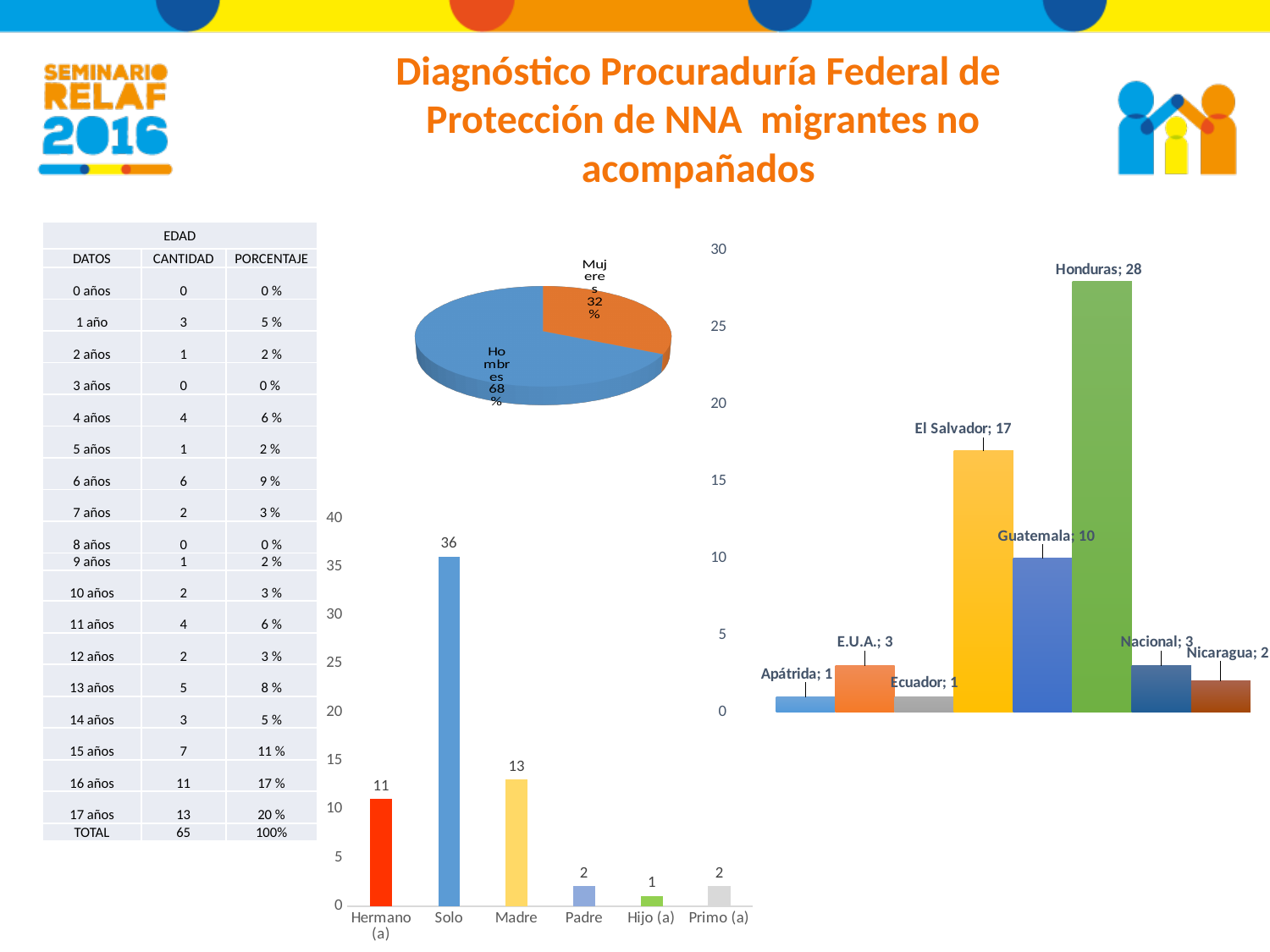
In the bar chart at the bottom centre of the slide, what is the value for Solo? 36 In the bar chart at the bottom centre of the slide, which is larger, Hermano (a) or Madre? Madre In the bar chart on the right of the slide, which category has the highest value? Honduras In the pie chart at the top centre of the slide, what share is labelled for Hombres? 68% In the bar chart at the bottom centre of the slide, how many categories are shown on the x axis? 6 What kind of chart is the chart at the top centre of the slide? Pie chart In the bar chart on the right of the slide, how many categories are plotted? 8 In the pie chart at the top centre of the slide, what share is labelled for Mujeres? 32% In the bar chart on the right of the slide, what is the value for El Salvador? 17 In the bar chart on the right of the slide, what is the difference between Honduras and Guatemala? 18 In the bar chart at the bottom centre of the slide, which category has the lowest value? Hijo (a) In the bar chart at the bottom centre of the slide, what is the difference between Solo and Madre? 23